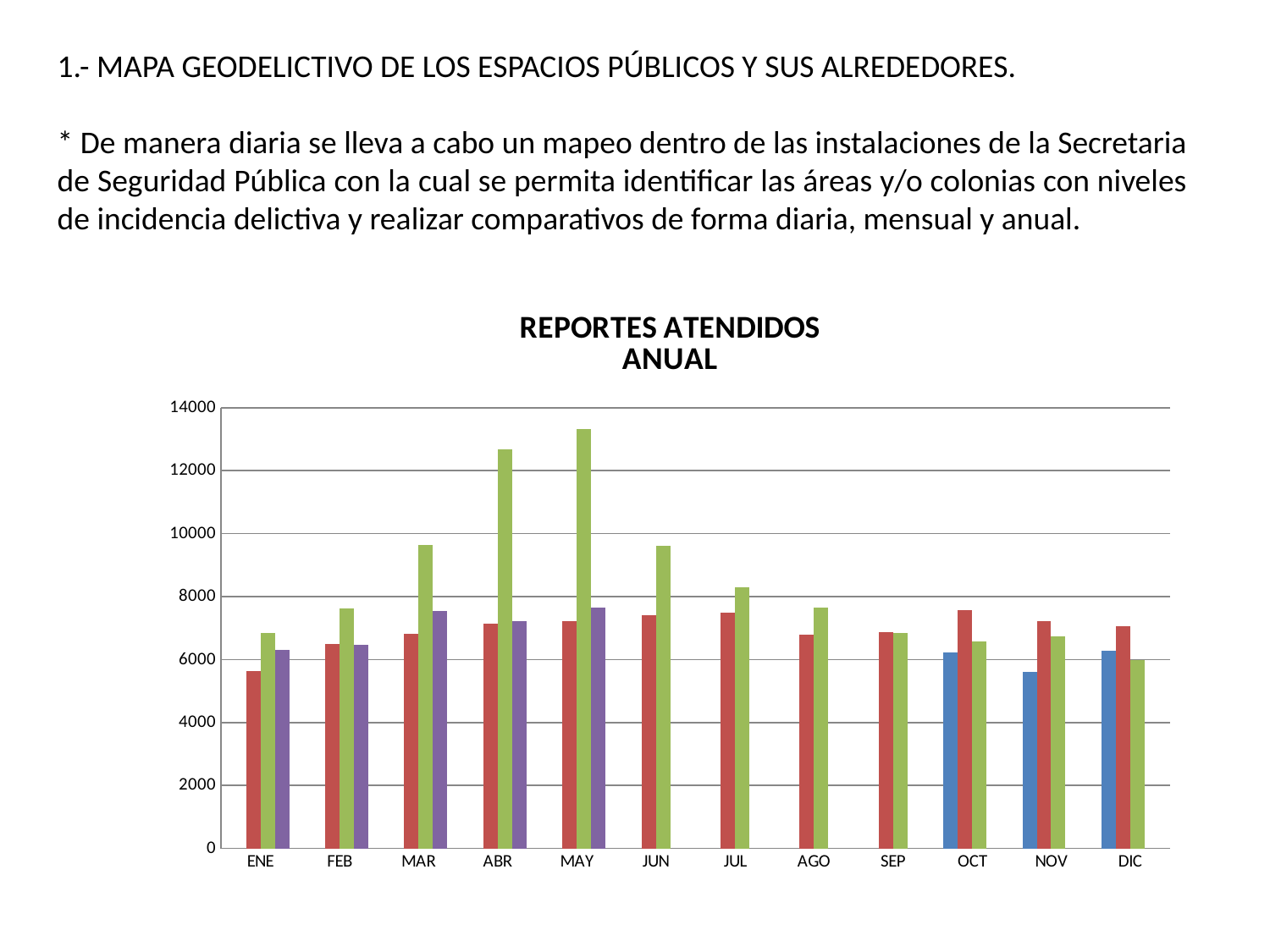
In which month is the red bar the lowest? ENE Is the green bar for MAR greater or less than 10000? less How many different bar colours (series) appear in the chart? 4 Is the red bar for ENE greater or less than 6000? less In OCT, which bar is taller, the red one or the green one? red Do the green bars rise or fall from MAY to DIC? fall In MAY, which bar is taller, the green one or the red one? green Is the green bar for MAY greater or less than 12000? greater What kind of chart is shown under the title REPORTES ATENDIDOS ANUAL? bar chart In which month is the green bar the highest? MAY What is the title of the chart? REPORTES ATENDIDOS ANUAL How many months are shown along the x axis of the chart? 12